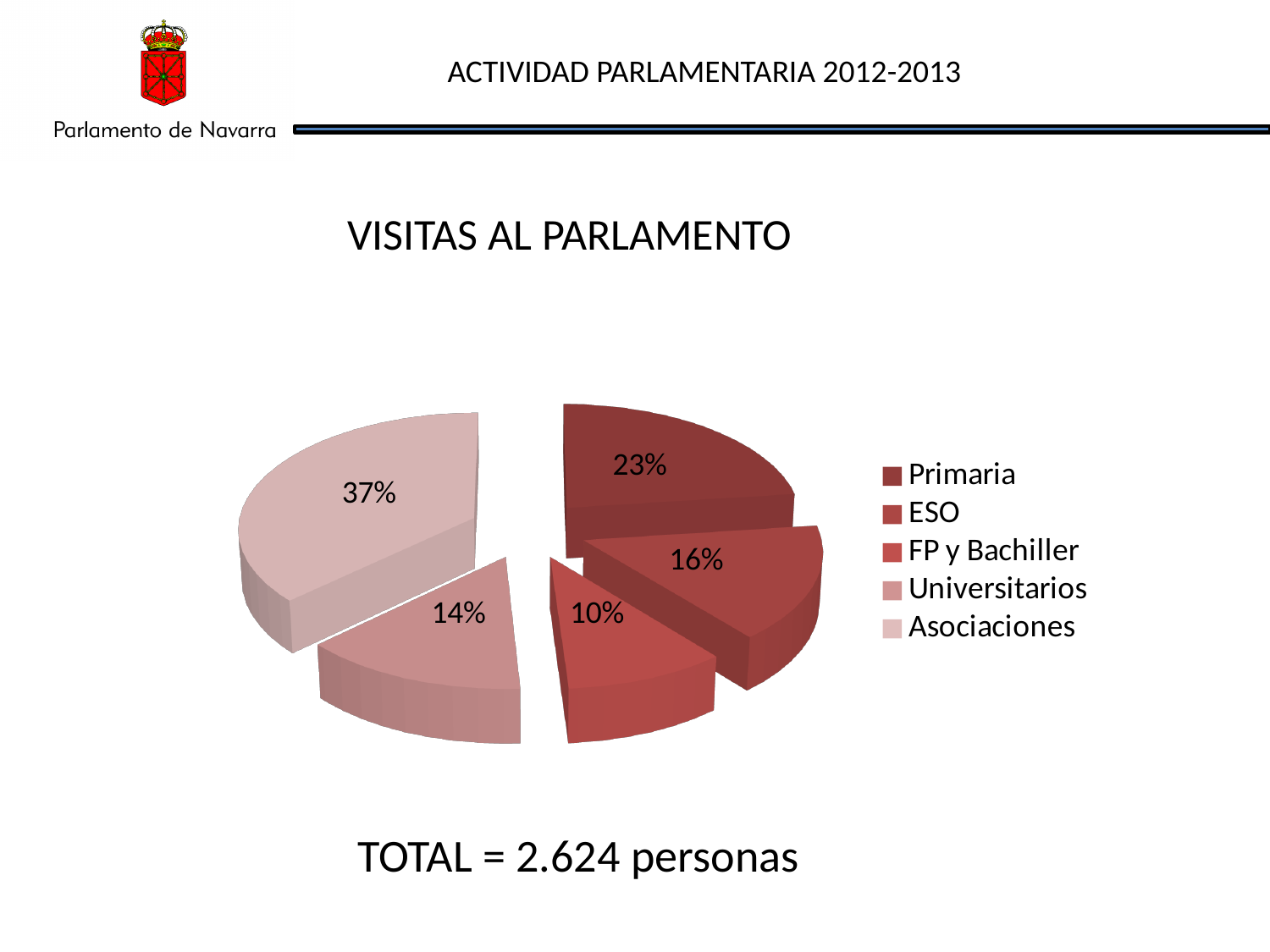
Which category has the smallest slice of the pie? FP y Bachiller What is the difference in percentage points between Asociaciones and Primaria? 14 What share of the pie does Universitarios represent? 14% What is the title of the chart? VISITAS AL PARLAMENTO What share of the pie does FP y Bachiller represent? 10% What share of the pie does ESO represent? 16% Which category has the largest slice of the pie? Asociaciones Which is larger, the share for ESO or the share for Universitarios? ESO What type of chart is shown on the slide? Pie chart How many categories does the pie chart show? 5